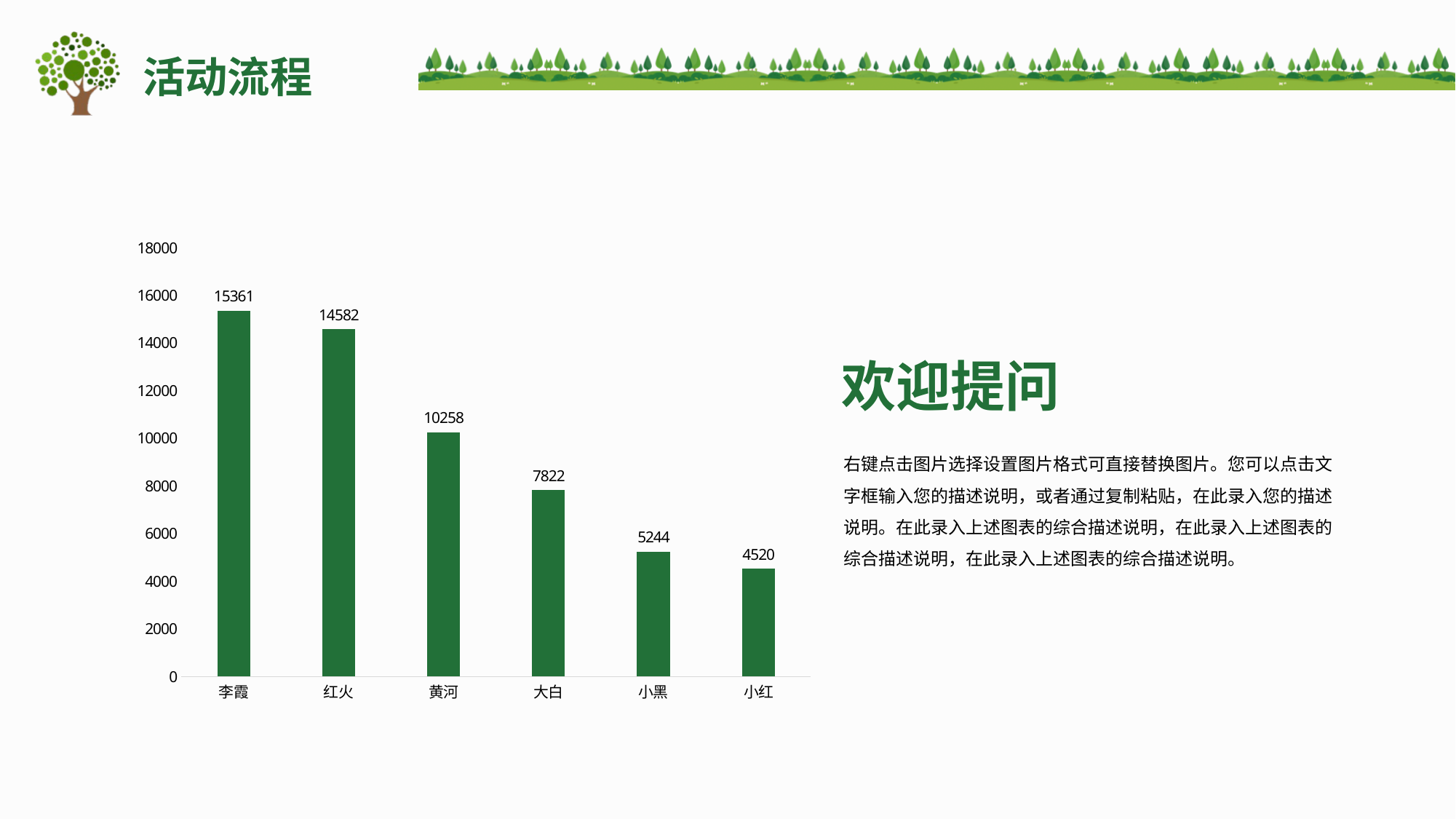
What kind of chart is shown on the slide? bar chart Which category has the highest value? 李霞 Do the values rise or fall from left to right along the x axis? fall How many categories are shown on the x axis? 6 What is the value for 小红? 4520 Which category has the lowest value? 小红 What is the value for 黄河? 10258 Is the value for 小黑 greater or less than 6000? less What is the difference between the values for 大白 and 小黑? 2578 What is the value for 李霞? 15361 Which is larger, the value for 黄河 or the value for 大白? 黄河 What is the difference between the values for 李霞 and 红火? 779